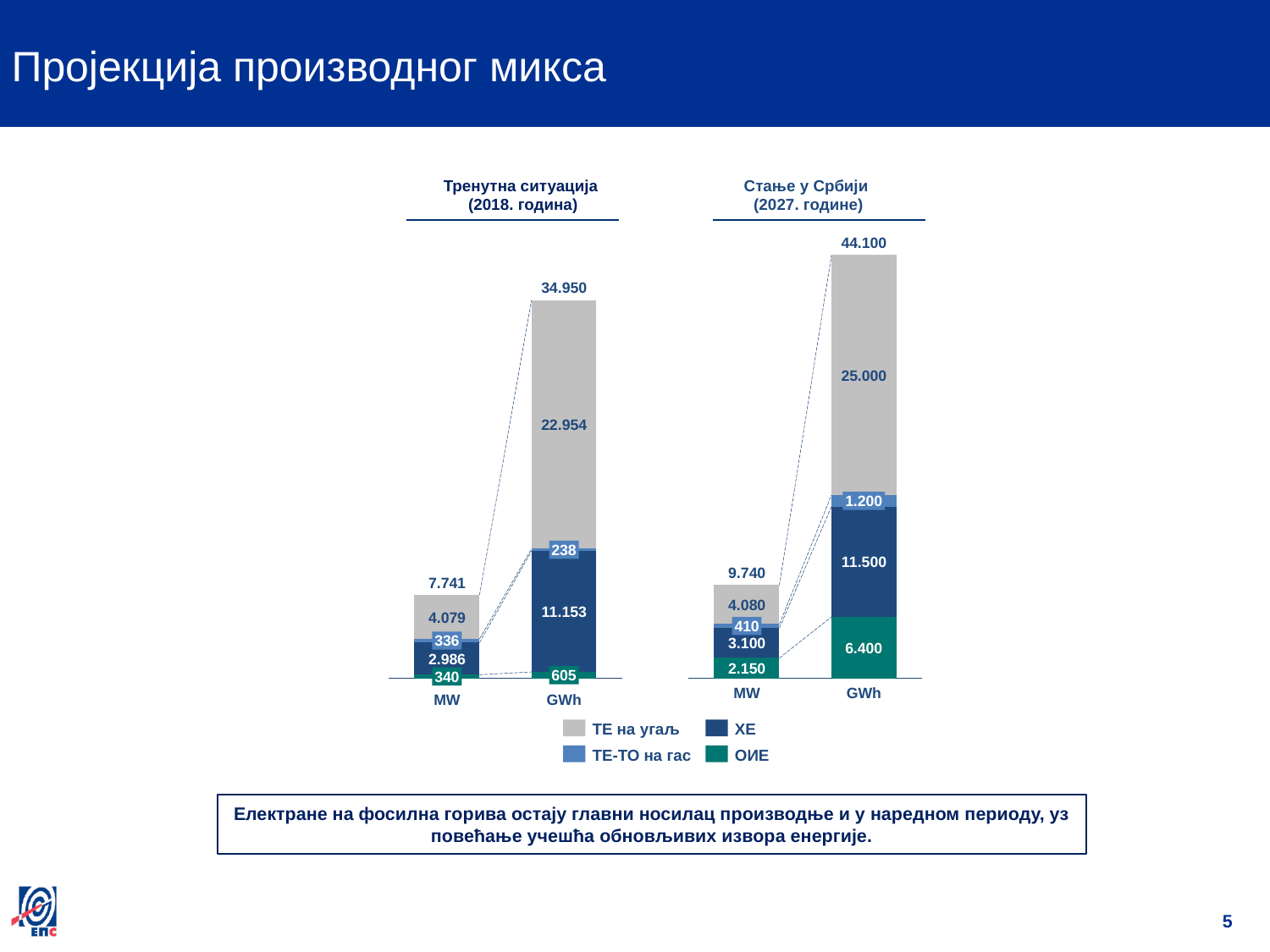
In the 'Стање у Србији (2027. године)' chart, what is the total of the MW bar? 9.740 In the 'Стање у Србији (2027. године)' chart, which series has the largest value in the GWh bar? ТЕ на угаљ Which is larger: the ХЕ value in the 2027 GWh bar or the ХЕ value in the 2018 GWh bar? 2027 GWh (11.500) In the 'Тренутна ситуација (2018. година)' chart, which series has the smallest value in the MW bar? ТЕ-ТО на гас In the 'Тренутна ситуација (2018. година)' chart, what is the total of the GWh bar? 34.950 In the 'Тренутна ситуација (2018. година)' chart, what is the value of ХЕ in the MW bar? 2.986 In the 'Тренутна ситуација (2018. година)' chart, what is the value of ТЕ-ТО на гас in the GWh bar? 238 What is the difference between the ОИЕ value in the GWh bar of the 2027 chart (6.400) and the ОИЕ value in the GWh bar of the 2018 chart (605)? 5.795 In the 'Стање у Србији (2027. године)' chart, what is the value of ОИЕ in the MW bar? 2.150 How many series does the legend list? 4 What type of chart is used on this slide? Stacked bar chart In the 'Стање у Србији (2027. године)' chart, what is the value of ТЕ на угаљ in the GWh bar? 25.000